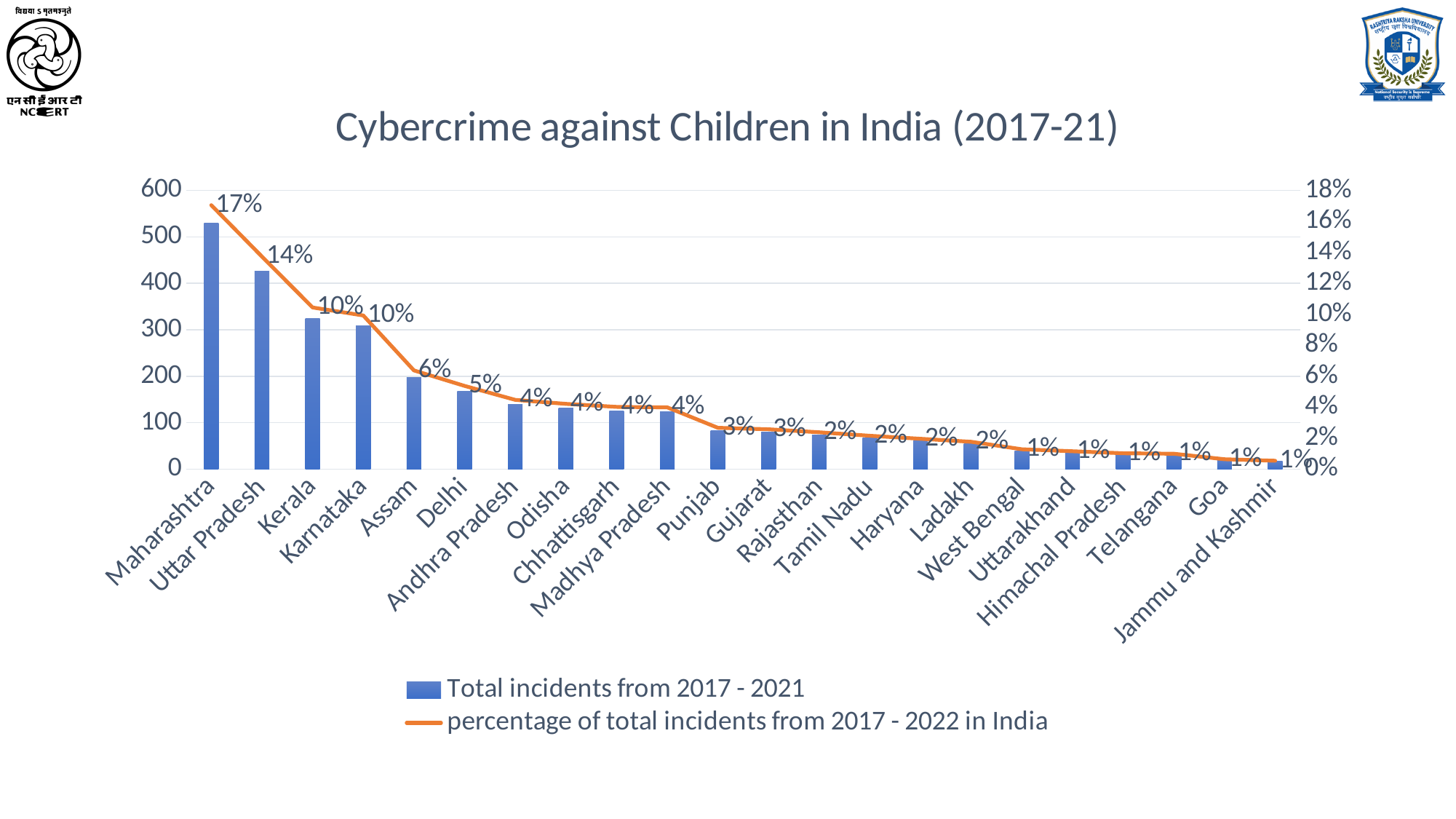
What percentage of total incidents is shown for Assam? 6% Which has a higher percentage of total incidents, Kerala or Assam? Kerala What percentage of total incidents is shown for Delhi? 5% Is the total incidents value for Maharashtra greater or less than 500? greater Is the total incidents value for Punjab greater or less than 100? less How many states or union territories are shown on the x axis? 22 What percentage of total incidents is shown for Uttar Pradesh? 14% What is the difference in percentage points between Maharashtra and Uttar Pradesh? 3% Do the total incidents values rise or fall from left to right along the x axis? fall What percentage of total incidents is shown for Maharashtra? 17% How many series does the legend list? 2 Which state has the highest percentage of total incidents? Maharashtra